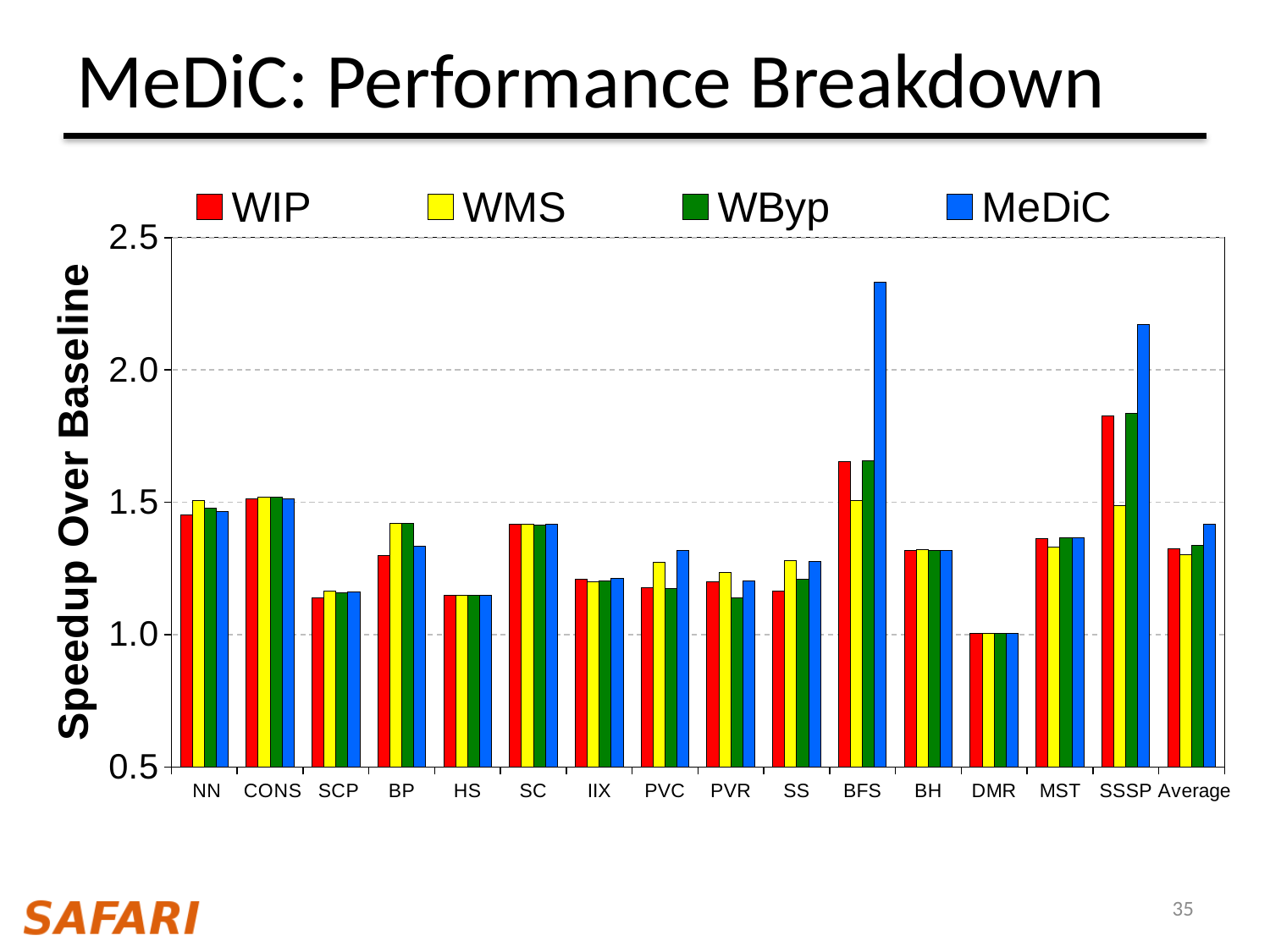
Is the MeDiC value for SSSP greater or less than 2.0? greater Which category has the highest MeDiC speedup? BFS Is the MeDiC value for BFS larger than the MeDiC value for SSSP? yes Is the MeDiC value for BFS greater or less than 2.0? greater How many series does the legend list? 4 Which category has the lowest speedup across all series? DMR How many categories are shown along the x axis? 16 Which is larger for WIP: SSSP or BFS? SSSP What is the label of the y axis? Speedup Over Baseline What kind of chart is shown on the slide? bar chart Is the WIP value for SCP greater or less than 1.5? less